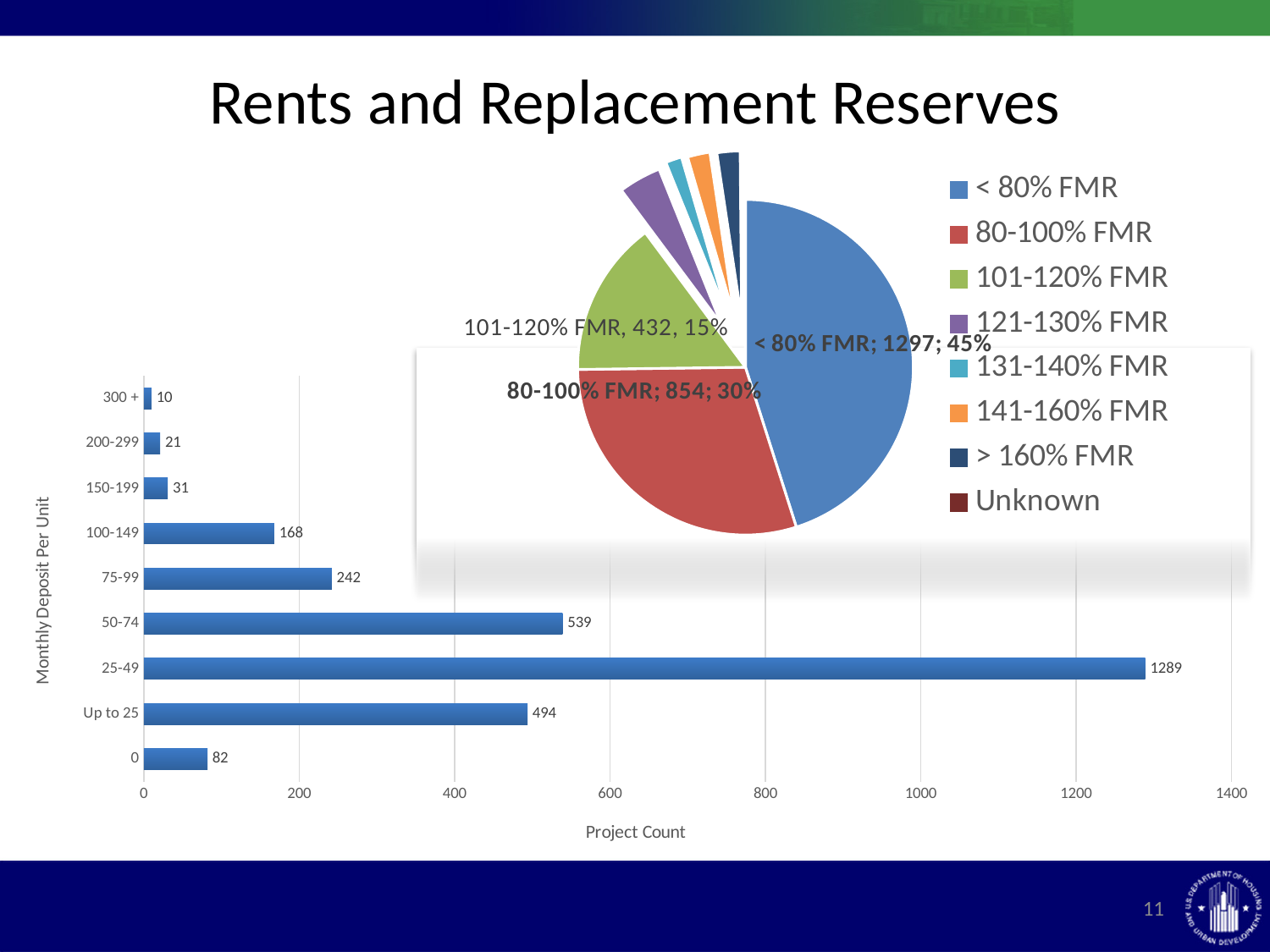
How many monthly deposit categories are shown in the bar chart at the bottom left? 9 In the bar chart at the bottom left, what is the project count for the 50-74 category? 539 In the pie chart on the right, what share of the pie does the 80-100% FMR slice represent? 30% In the bar chart at the bottom left, which monthly deposit category has the highest project count? 25-49 In the bar chart at the bottom left, what is the project count for the 300 + category? 10 In the pie chart on the right, what value is shown for the < 80% FMR slice? 1297 What type of chart is the chart at the bottom left of the slide? Bar chart In the bar chart at the bottom left, which monthly deposit category has the lowest project count? 300 + In the bar chart at the bottom left, which has a larger project count, 75-99 or 100-149? 75-99 How many entries does the legend of the pie chart on the right list? 8 In the bar chart at the bottom left, what is the difference in project count between the Up to 25 and 0 categories? 412 In the bar chart at the bottom left, what is the project count for the 25-49 monthly deposit category? 1289